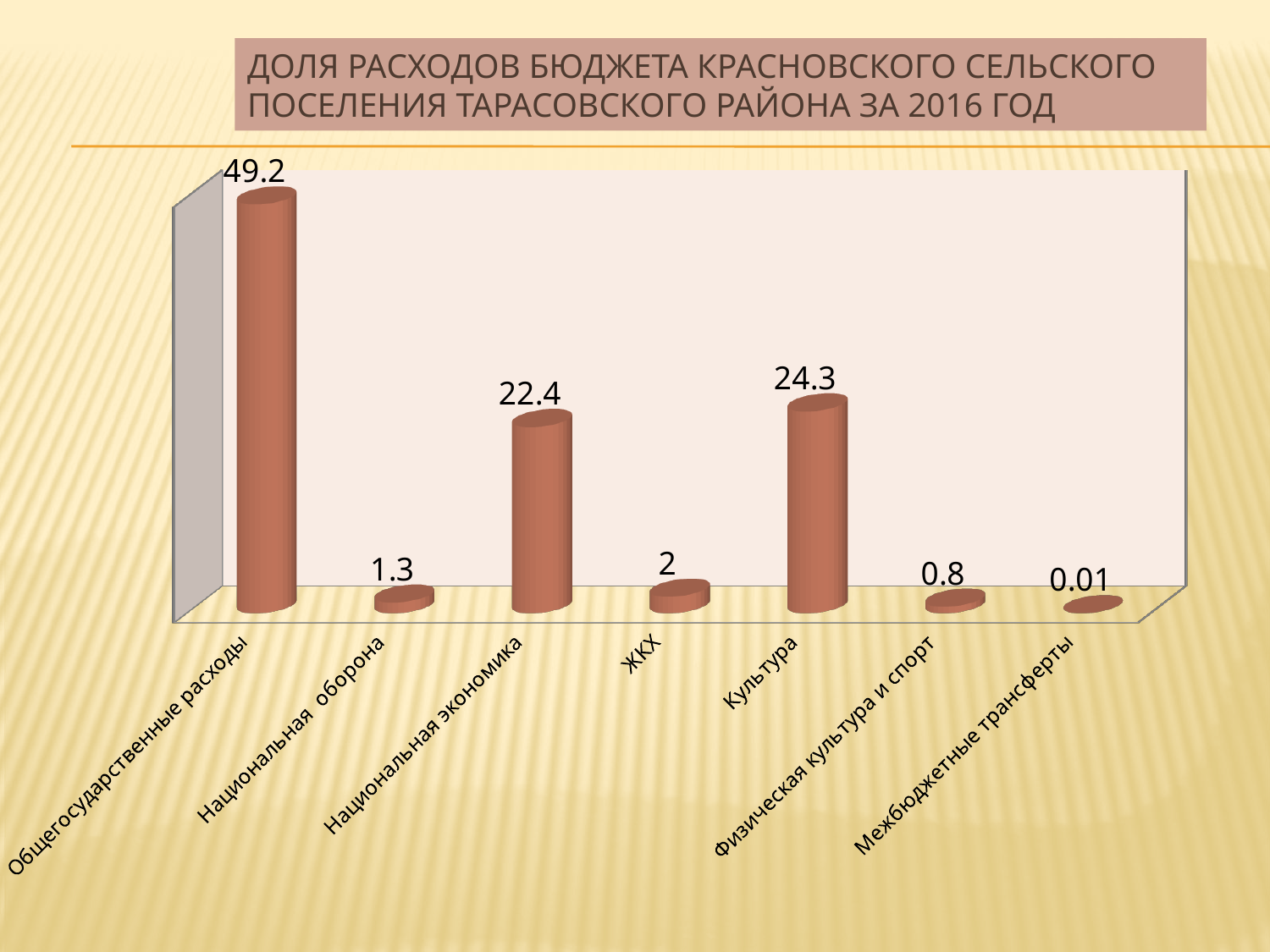
How many categories are shown on the chart? 7 What is the value for Национальная экономика? 22.4 What is the value for ЖКХ? 2 Which year does the chart title refer to? 2016 Which is larger, the value for Национальная оборона or the value for ЖКХ? ЖКХ What is the value for Межбюджетные трансферты? 0.01 What is the value for Общегосударственные расходы? 49.2 What is the value for Культура? 24.3 What is the difference between the values for Культура and Национальная экономика? 1.9 Which category has the highest value? Общегосударственные расходы Which category has the lowest value? Межбюджетные трансферты What kind of chart is shown on the slide? Bar chart